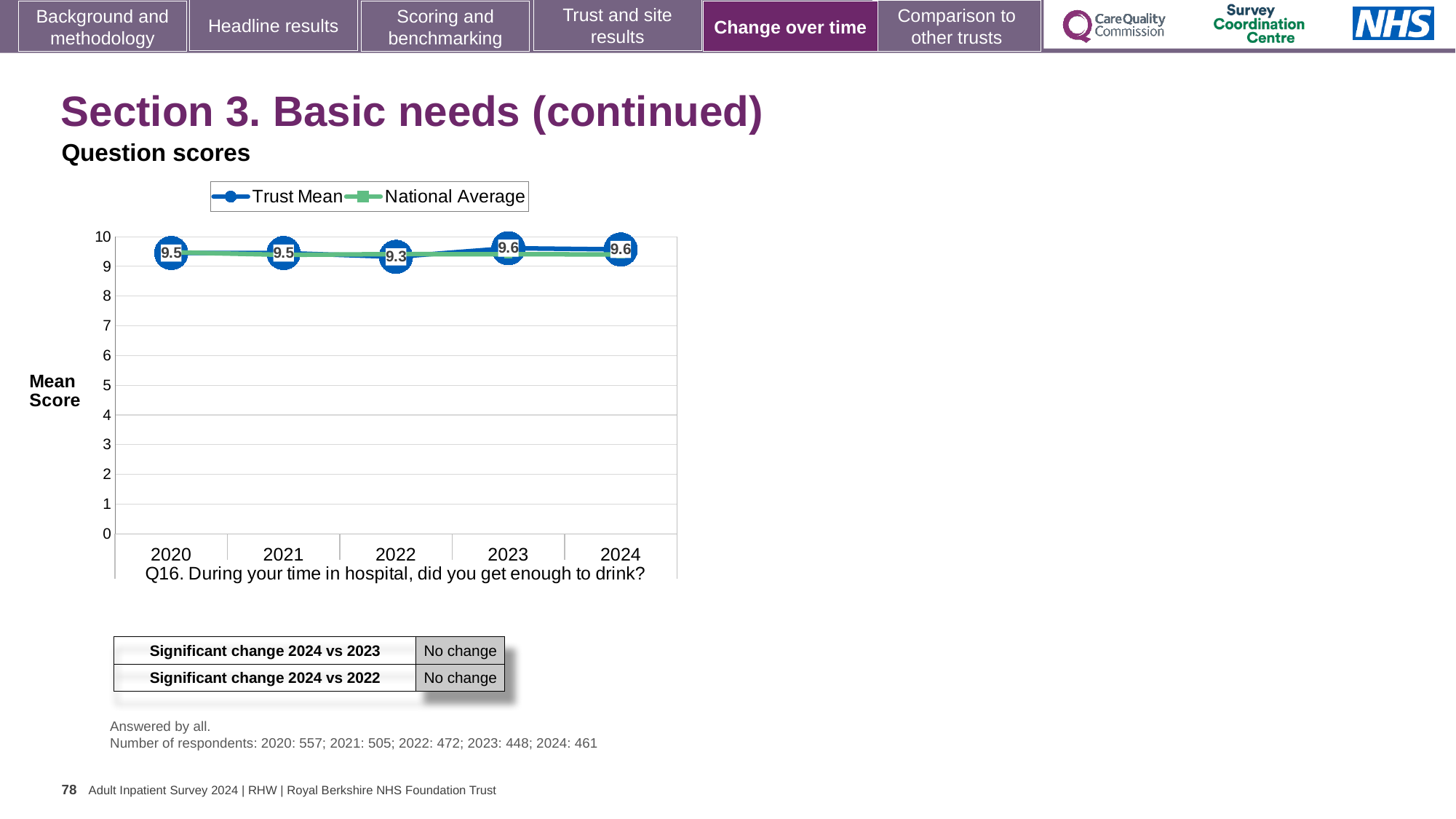
What is the Trust Mean score for 2022? 9.3 What is the Trust Mean score for 2024? 9.6 How many years are plotted on the x axis? 5 Which year has the larger Trust Mean score, 2021 or 2022? 2021 What is the difference between the Trust Mean scores for 2023 and 2022? 0.3 Which question does the chart show scores for? Q16. During your time in hospital, did you get enough to drink? In which year is the Trust Mean score lowest? 2022 How many series does the legend list? 2 What kind of chart is shown on the slide? Line chart What is the Trust Mean score for 2020? 9.5 Is the National Average value for 2024 greater or less than 9? greater Does the Trust Mean score rise or fall from 2022 to 2024? Rise